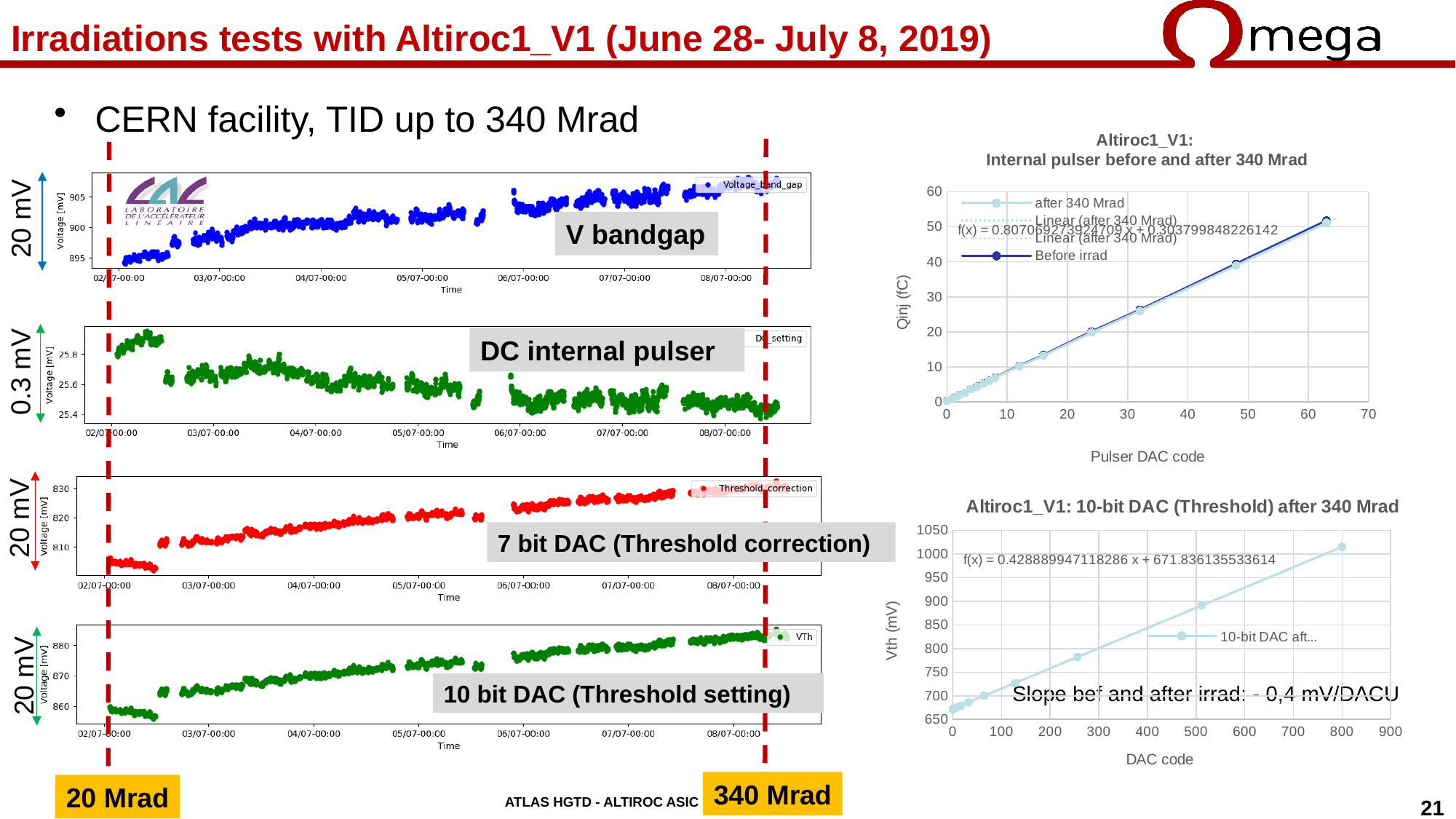
In the chart titled 'Altiroc1_V1: Internal pulser before and after 340 Mrad', is the Qinj value at Pulser DAC code 63 greater or less than 40? greater In the 'V bandgap' time-series chart on the left, does the voltage rise or fall over time from 02/07 to 08/07? rise In the chart titled 'Altiroc1_V1: Internal pulser before and after 340 Mrad', is the Qinj value at Pulser DAC code 32 greater or less than 30? less How many entries does the legend of the chart titled 'Altiroc1_V1: Internal pulser before and after 340 Mrad' list? 4 What is the y-axis label of the chart titled 'Altiroc1_V1: 10-bit DAC (Threshold) after 340 Mrad'? Vth (mV) In the 'DC internal pulser' time-series chart on the left, does the voltage rise or fall overall from 02/07 to 08/07? fall In the chart titled 'Altiroc1_V1: Internal pulser before and after 340 Mrad', does Qinj rise or fall as the Pulser DAC code increases? rise In the chart titled 'Altiroc1_V1: 10-bit DAC (Threshold) after 340 Mrad', is the Vth value at DAC code 256 greater or less than 750? greater What is the title of the top-right chart? Altiroc1_V1: Internal pulser before and after 340 Mrad